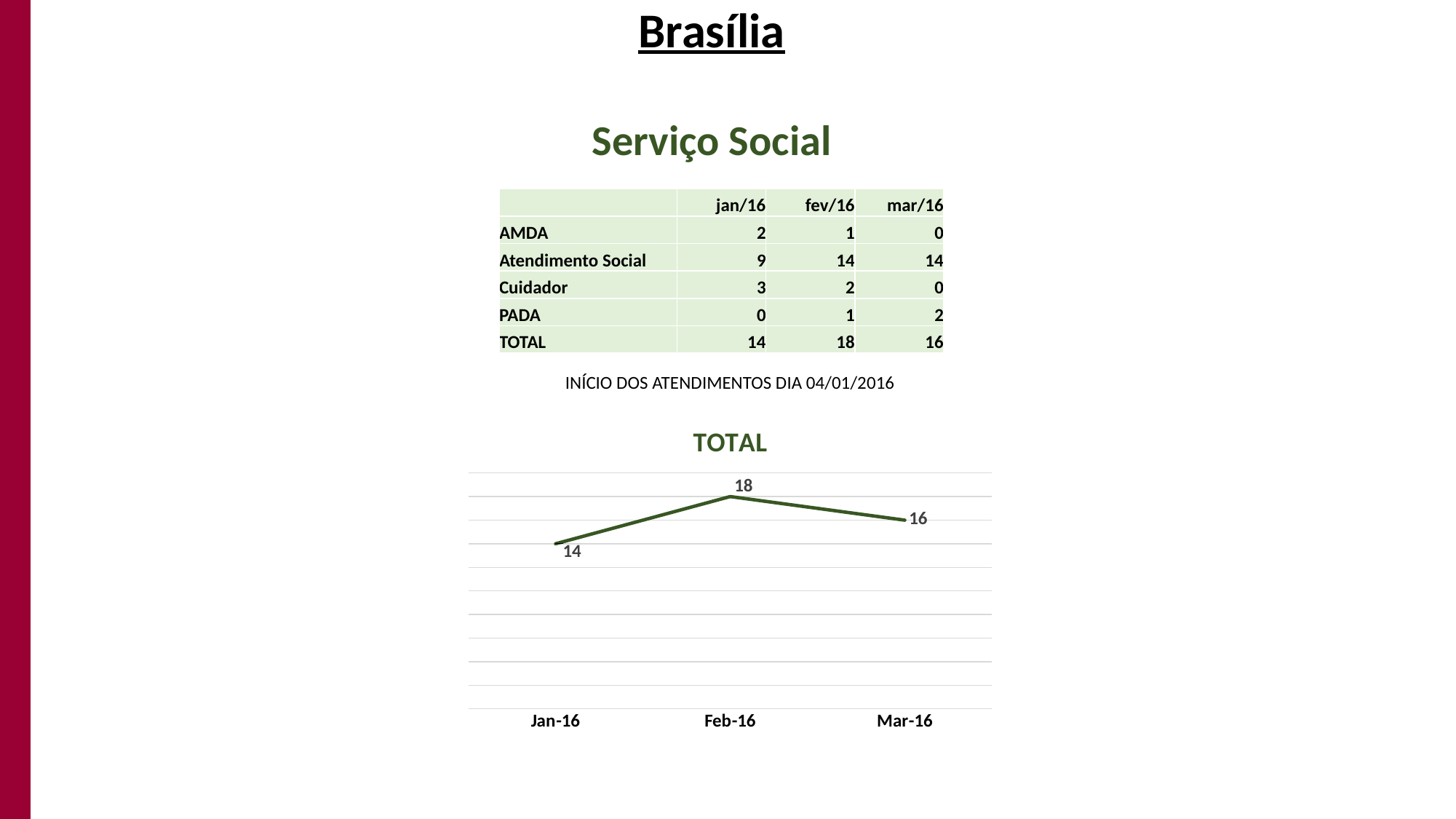
What is the value for Jan-16 in the TOTAL chart? 14 What is the value for Feb-16 in the TOTAL chart? 18 What is the difference between the Feb-16 and Mar-16 values in the TOTAL chart? 2 What is the value for Mar-16 in the TOTAL chart? 16 What kind of chart is the TOTAL chart? line chart Which month has the highest value in the TOTAL chart? Feb-16 How many data points are plotted in the TOTAL chart? 3 Does the value in the TOTAL chart rise or fall from Feb-16 to Mar-16? fall What is the title of the chart on the slide? TOTAL Which is larger in the TOTAL chart, the value for Mar-16 or the value for Jan-16? Mar-16 What is the difference between the Feb-16 and Jan-16 values in the TOTAL chart? 4 Which month has the lowest value in the TOTAL chart? Jan-16